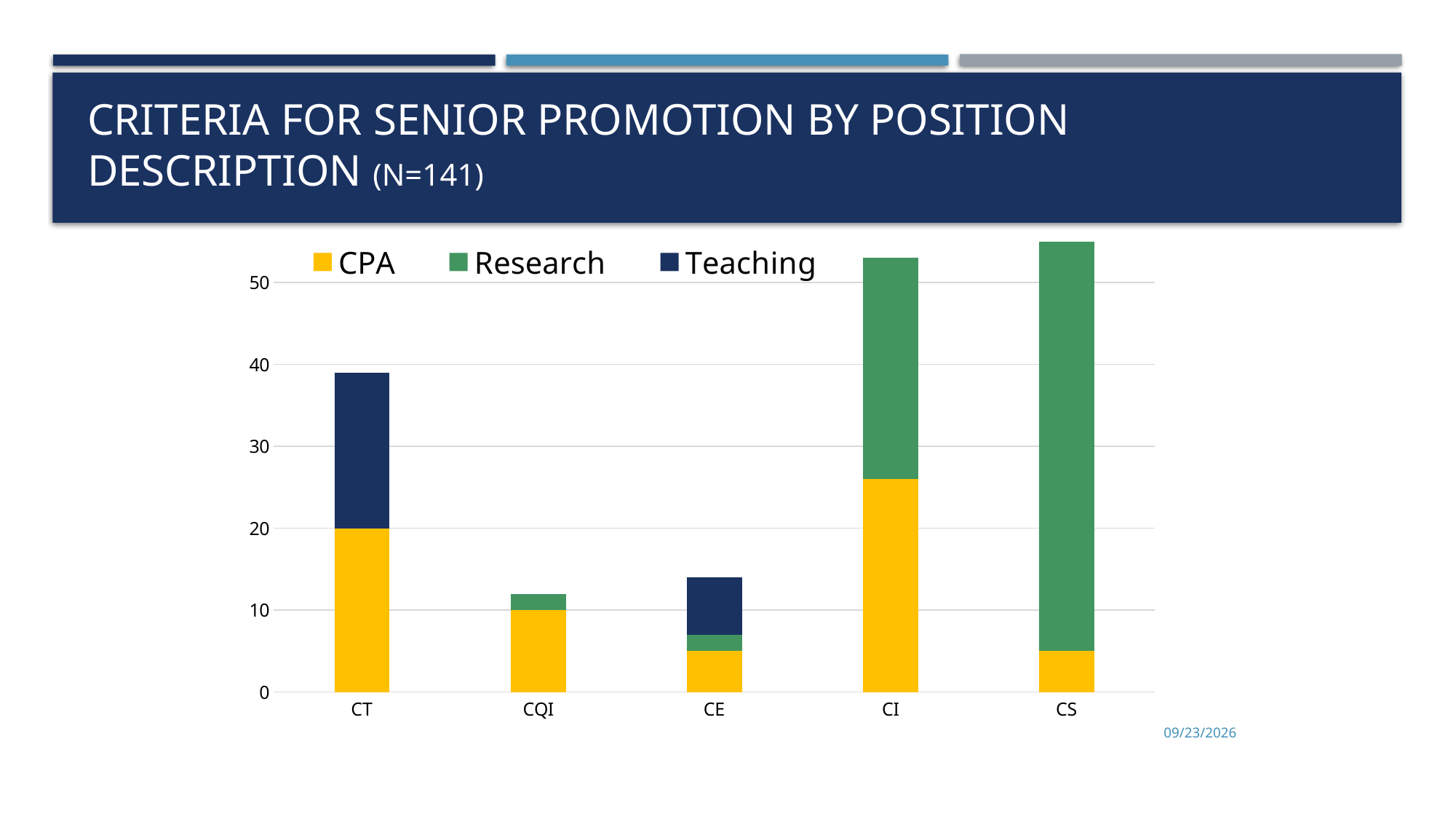
Which category has a Teaching segment but no Research segment? CT Is the total stacked value for CQI greater or less than 20? less How many series does the legend list? 3 Which has the larger total stacked bar, CT or CI? CI What type of chart is shown on the slide? stacked bar chart Is the total stacked value for CS greater or less than 50? greater Is the CPA value for CI greater or less than 20? greater How many position categories are shown on the x axis? 5 Which category has the larger CPA segment, CS or CT? CT Which category has the tallest stacked bar overall? CS Which series is shown in yellow in the legend? CPA